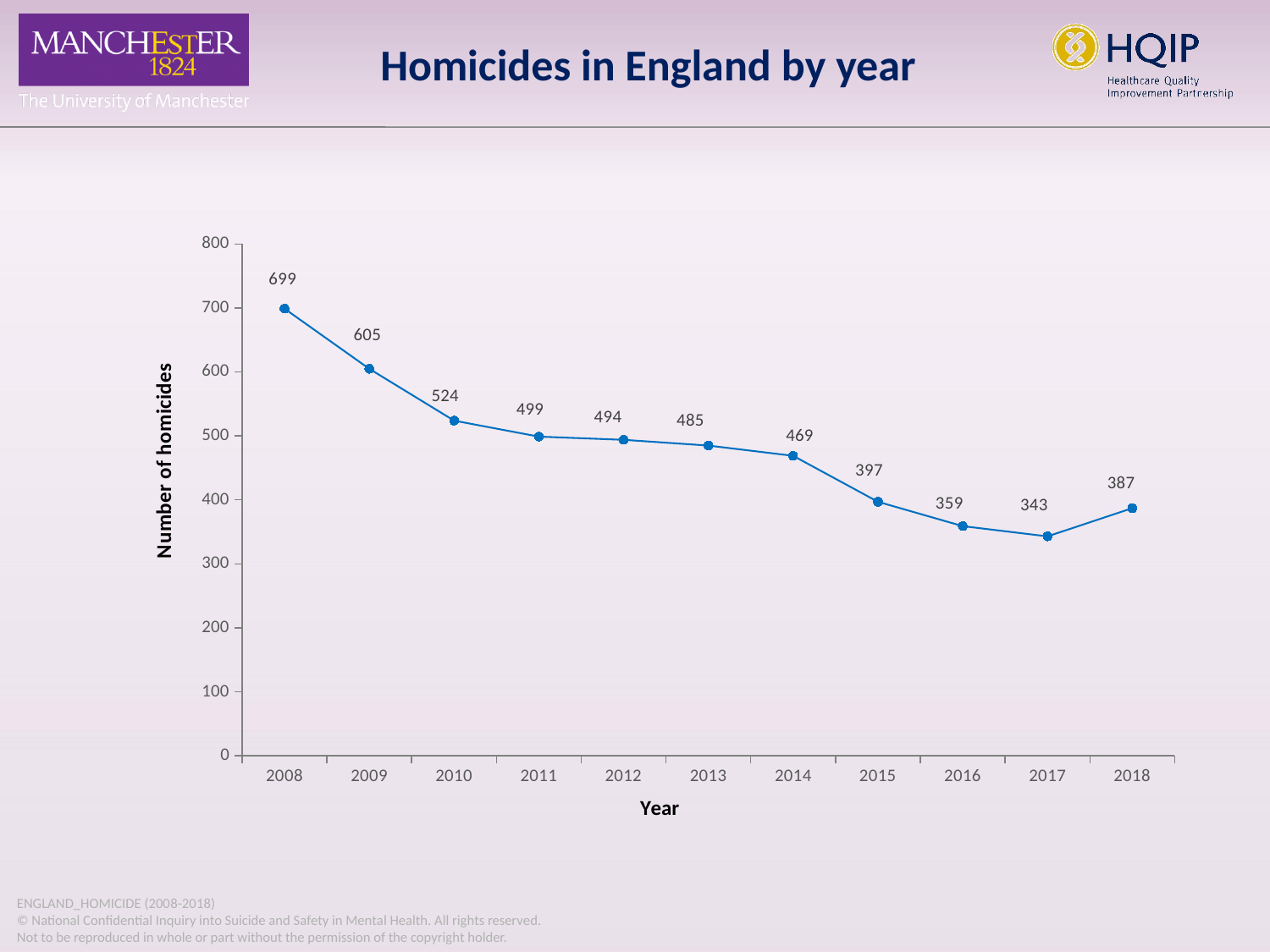
Is the value for 2016 greater or less than 400? less What is the difference in the number of homicides between 2008 and 2009? 94 What is the number of homicides in 2008? 699 What is the number of homicides in 2018? 387 How many years are plotted on the chart? 11 What is the number of homicides in 2015? 397 Which year has the lowest number of homicides? 2017 Which year has the highest number of homicides? 2008 Which year has more homicides, 2010 or 2014? 2010 Do the values generally rise or fall from 2008 to 2017? Fall What is the difference in the number of homicides between 2017 and 2018? 44 What kind of chart is shown on the slide? Line chart